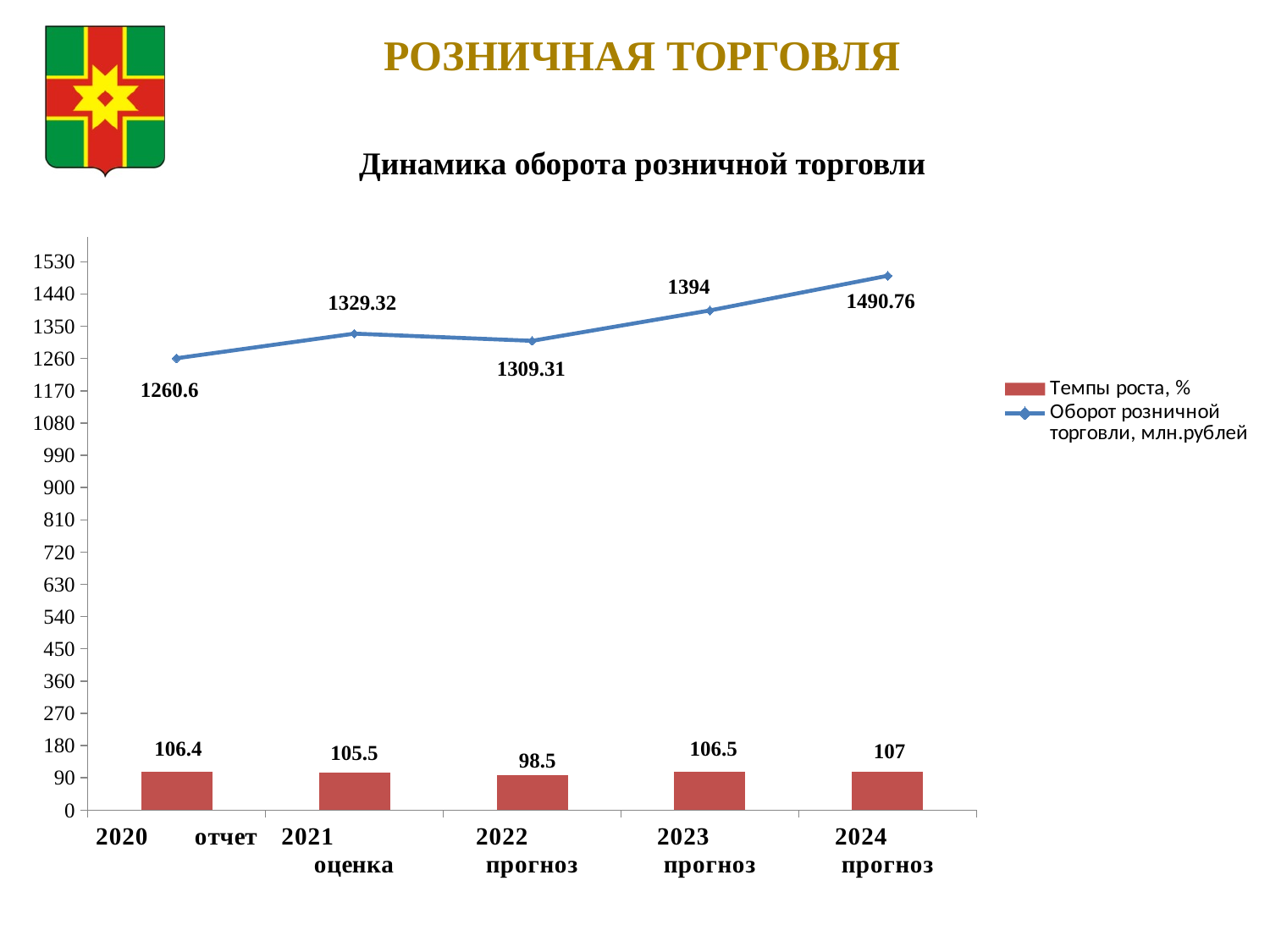
What is the value of 'Темпы роста, %' for 2022 прогноз? 98.5 How many series does the legend list? 2 Is the value of 'Оборот розничной торговли, млн.рублей' for 2023 прогноз greater or less than 1350? greater Which year has the highest value of 'Оборот розничной торговли, млн.рублей'? 2024 прогноз Which is larger, 'Оборот розничной торговли, млн.рублей' in 2021 оценка or in 2022 прогноз? 2021 оценка Which year has the lowest value of 'Темпы роста, %'? 2022 прогноз How many years are shown on the x axis of the chart? 5 What is the value of 'Оборот розничной торговли, млн.рублей' for 2020 отчет? 1260.6 What kind of chart is shown on the slide? Combined bar and line chart What is the title of the chart? Динамика оборота розничной торговли What is the difference between 'Оборот розничной торговли, млн.рублей' in 2023 прогноз and 2020 отчет? 133.4 What is the value of 'Оборот розничной торговли, млн.рублей' for 2024 прогноз? 1490.76